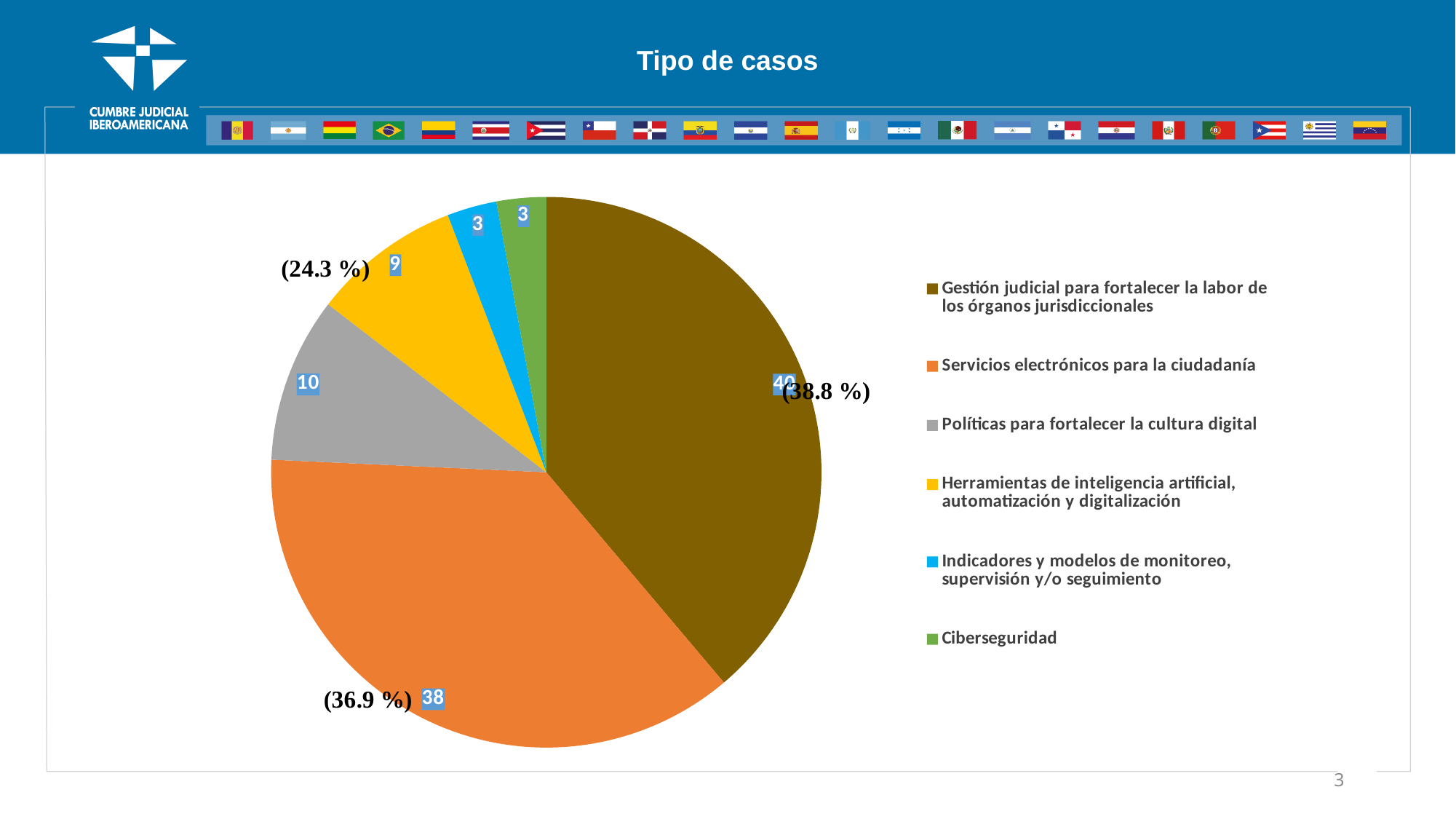
What percentage share is printed next to the 'Servicios electrónicos para la ciudadanía' slice? 36.9 % What is the value for 'Herramientas de inteligencia artificial, automatización y digitalización'? 9 Which category has the largest slice of the pie? Gestión judicial para fortalecer la labor de los órganos jurisdiccionales Which is larger, the value for 'Políticas para fortalecer la cultura digital' or the value for 'Herramientas de inteligencia artificial, automatización y digitalización'? Políticas para fortalecer la cultura digital What is the difference between the values for 'Gestión judicial para fortalecer la labor de los órganos jurisdiccionales' and 'Servicios electrónicos para la ciudadanía'? 2 What is the value for 'Servicios electrónicos para la ciudadanía'? 38 How many categories does the pie chart have? 6 What is the value for 'Ciberseguridad'? 3 What is the value for 'Políticas para fortalecer la cultura digital'? 10 What is the value for 'Gestión judicial para fortalecer la labor de los órganos jurisdiccionales'? 40 What kind of chart is shown on the slide? pie chart What is the title of the slide containing the pie chart? Tipo de casos